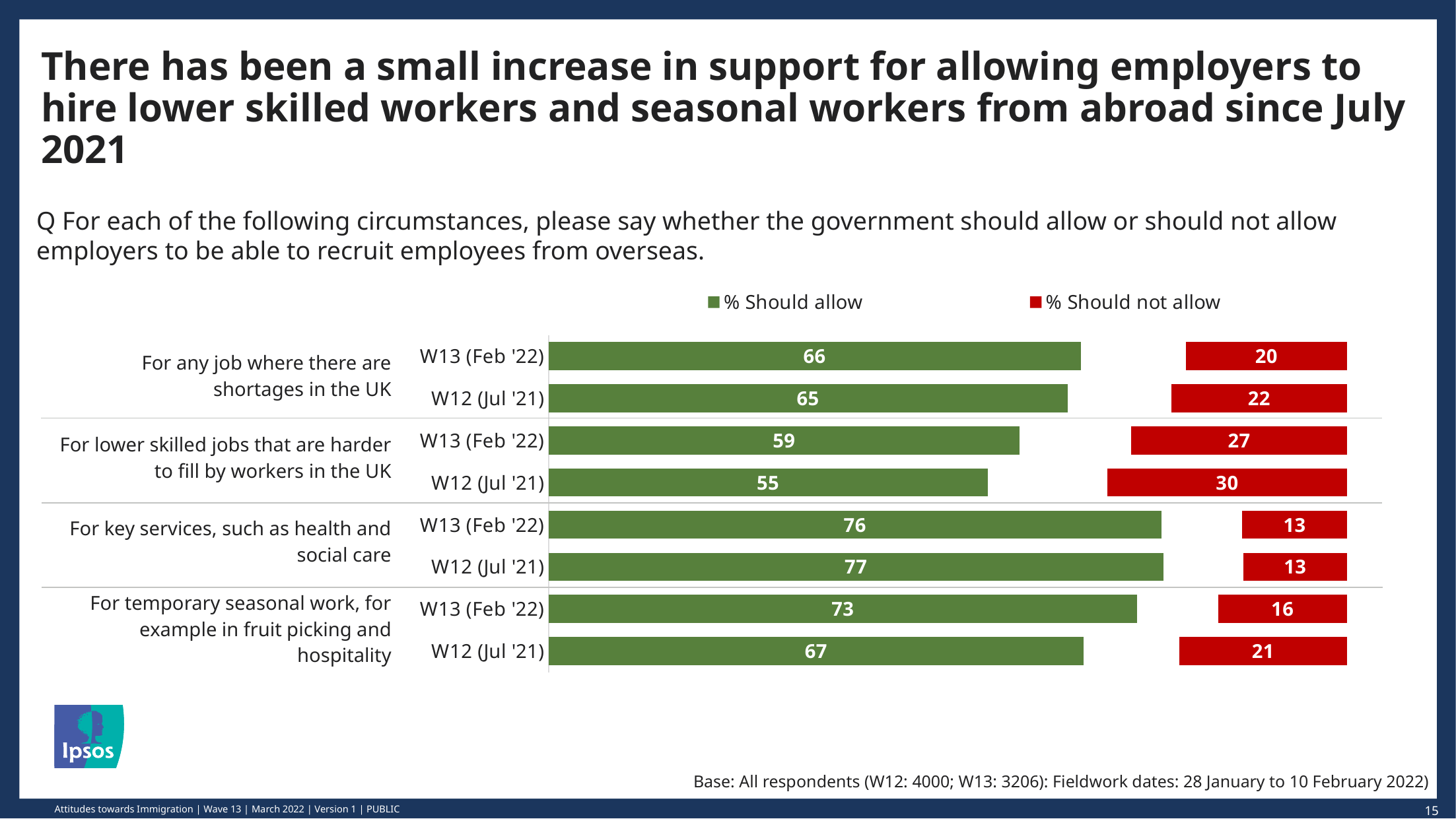
Which circumstance has the highest % Should allow value in W13 (Feb '22)? For key services, such as health and social care What colour represents '% Should not allow' in the chart? Red What is the % Should not allow value for 'For lower skilled jobs that are harder to fill by workers in the UK' in W12 (Jul '21)? 30 How many circumstances (question items) are shown in the chart? 4 By how many points did % Should allow for 'For temporary seasonal work, for example in fruit picking and hospitality' change between W12 (Jul '21) and W13 (Feb '22)? 6 Is the % Should not allow value higher in W12 (Jul '21) or W13 (Feb '22) for 'For lower skilled jobs that are harder to fill by workers in the UK'? W12 (Jul '21) What is the % Should allow value for 'For any job where there are shortages in the UK' in W13 (Feb '22)? 66 What kind of chart is shown on the slide? Bar chart How many series does the legend list? 2 What is the % Should allow value for 'For temporary seasonal work, for example in fruit picking and hospitality' in W12 (Jul '21)? 67 What is the difference between % Should allow and % Should not allow for 'For key services, such as health and social care' in W13 (Feb '22)? 63 Which circumstance has the lowest % Should allow value in W12 (Jul '21)? For lower skilled jobs that are harder to fill by workers in the UK